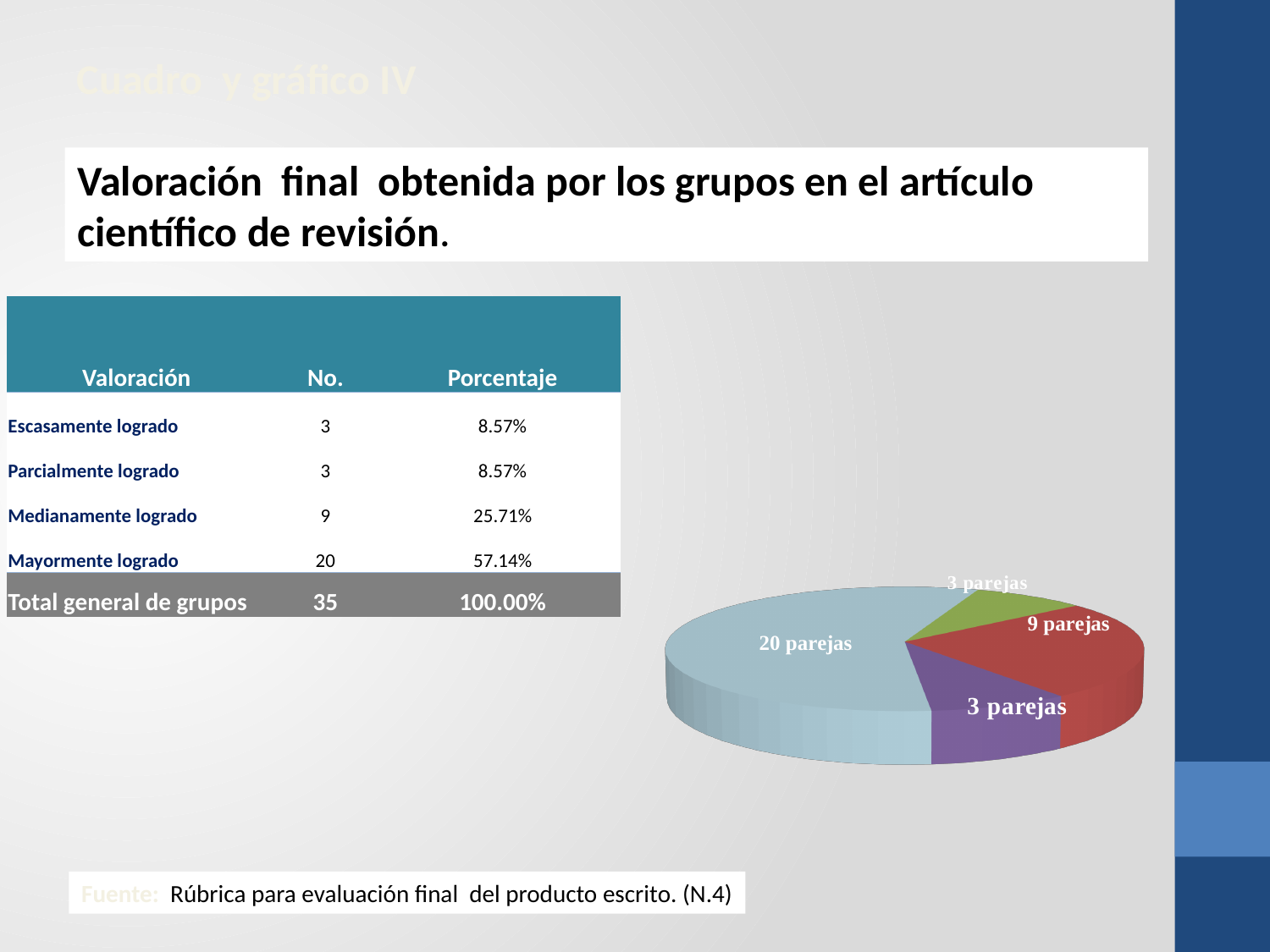
How many more parejas does the light blue slice represent than the red slice? 11 What is the data label on the red slice of the pie chart? 9 parejas What kind of chart is shown on the slide? pie chart What is the total number of parejas across all slices of the pie chart? 35 What is the data label on the green slice of the pie chart? 3 parejas What is the data label on the light blue slice of the pie chart? 20 parejas How many slices does the pie chart have? 4 How many slices of the pie chart are labelled '3 parejas'? 2 What is the data label on the largest slice of the pie chart? 20 parejas Which slice is larger in the pie chart, the light blue one or the red one? the light blue one What share of the pie does the 20 parejas slice represent? 57.14% What is the data label on the purple slice of the pie chart? 3 parejas